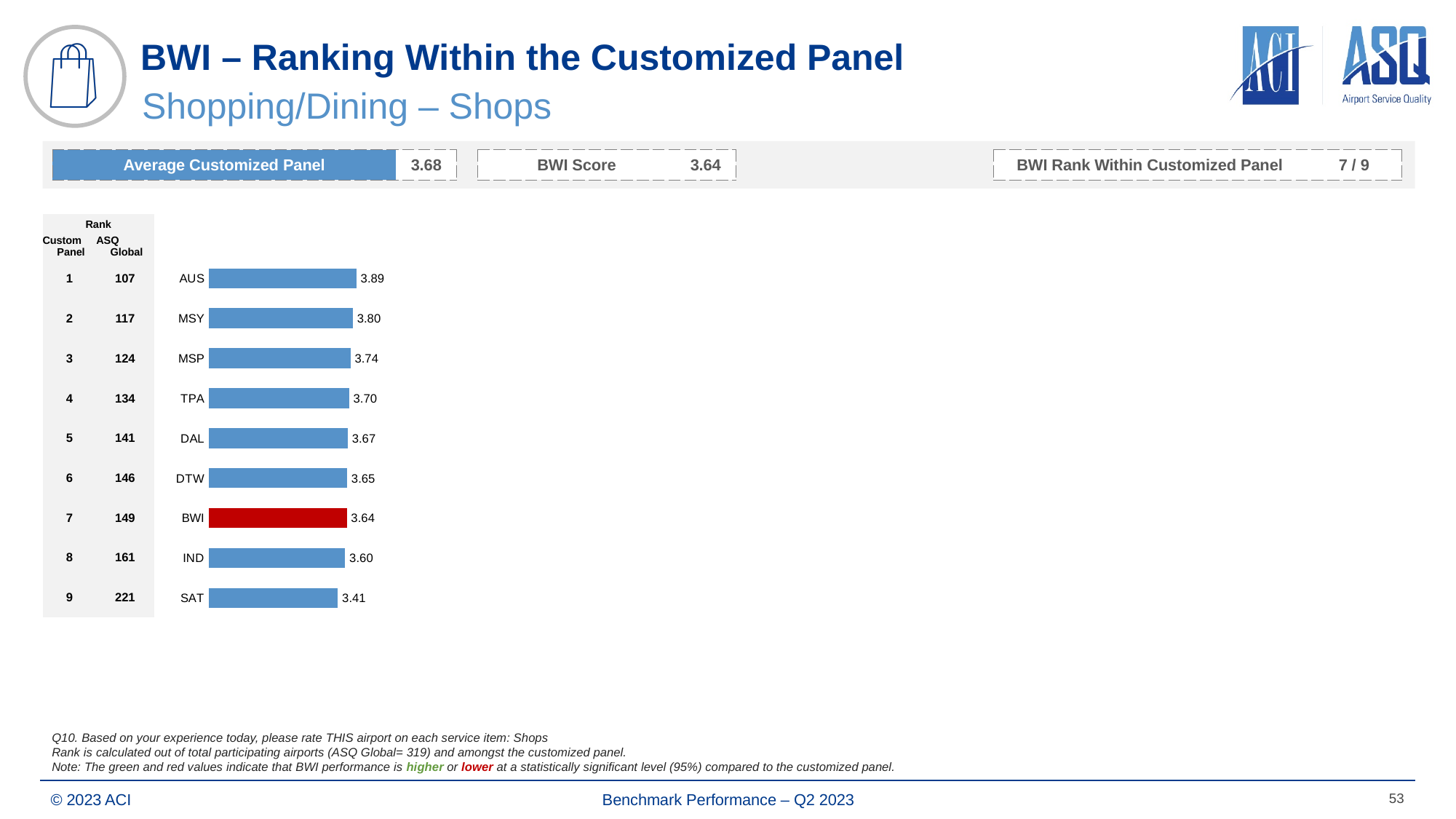
What is the score for SAT? 3.41 How many airports are shown in the chart? 9 Which airport has the lowest score? SAT Which has a higher score, TPA or IND? TPA What is the score for AUS? 3.89 What is the score for DTW? 3.65 Which airport's bar is coloured red? BWI What is the difference between the scores for AUS and SAT? 0.48 What is the score for BWI? 3.64 Which airport has the highest score? AUS What is the difference between the scores for MSY and BWI? 0.16 What kind of chart is shown on the slide? Bar chart